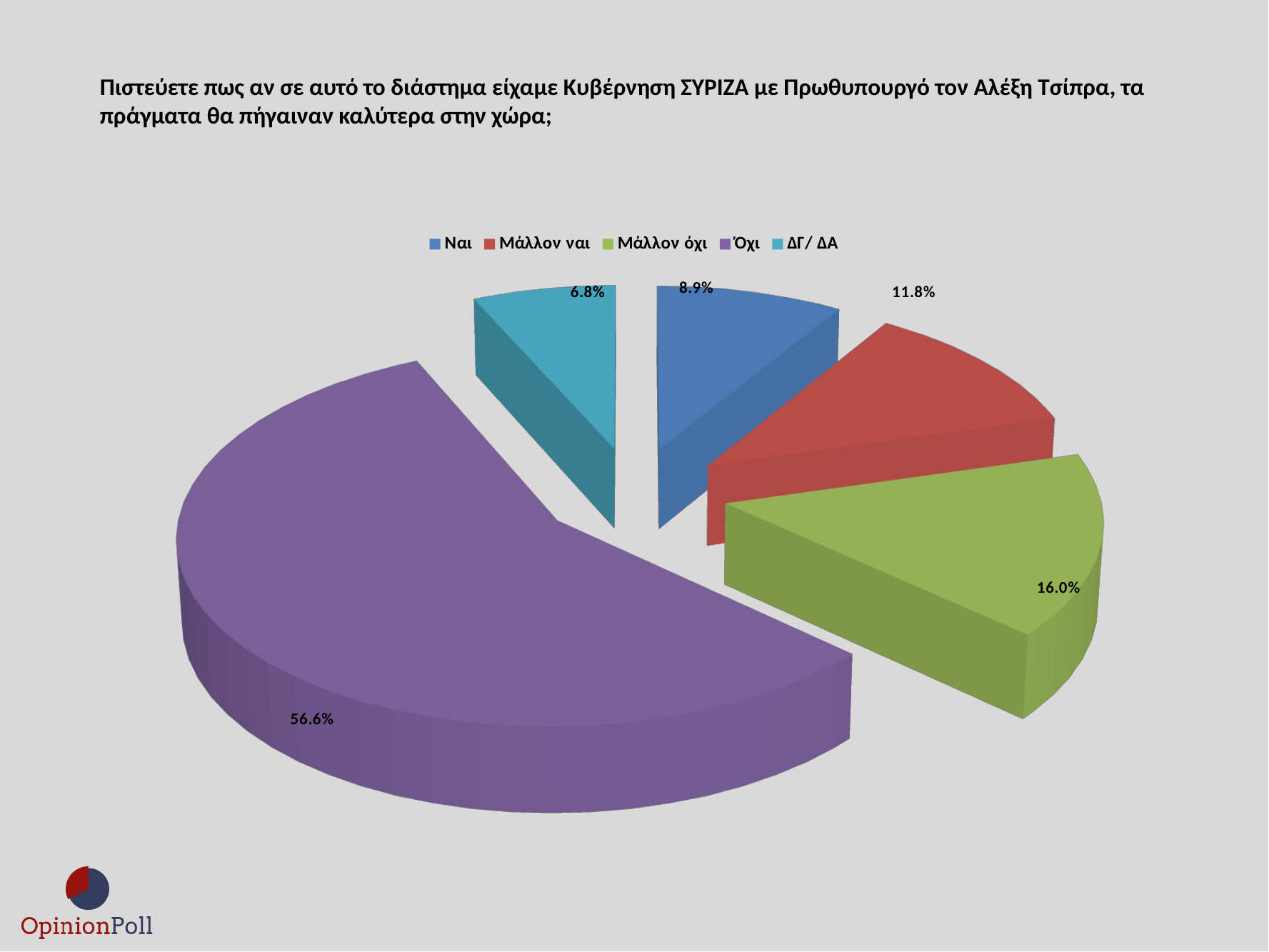
What percentage of respondents answered "ΔΓ/ ΔΑ"? 6.8% What colour is the slice for "Όχι"? Purple Which response has the smallest share of the pie? ΔΓ/ ΔΑ Which is larger, the share for "Μάλλον ναι" or the share for "Ναι"? Μάλλον ναι What percentage of respondents answered "Ναι"? 8.9% What percentage of respondents answered "Μάλλον ναι"? 11.8% How many response categories does the pie chart show? 5 What kind of chart is shown on the slide? Pie chart Which response has the largest share of the pie? Όχι What percentage of respondents answered "Όχι"? 56.6% What percentage of respondents answered "Μάλλον όχι"? 16.0% What is the difference in percentage points between "Όχι" and "Μάλλον όχι"? 40.6